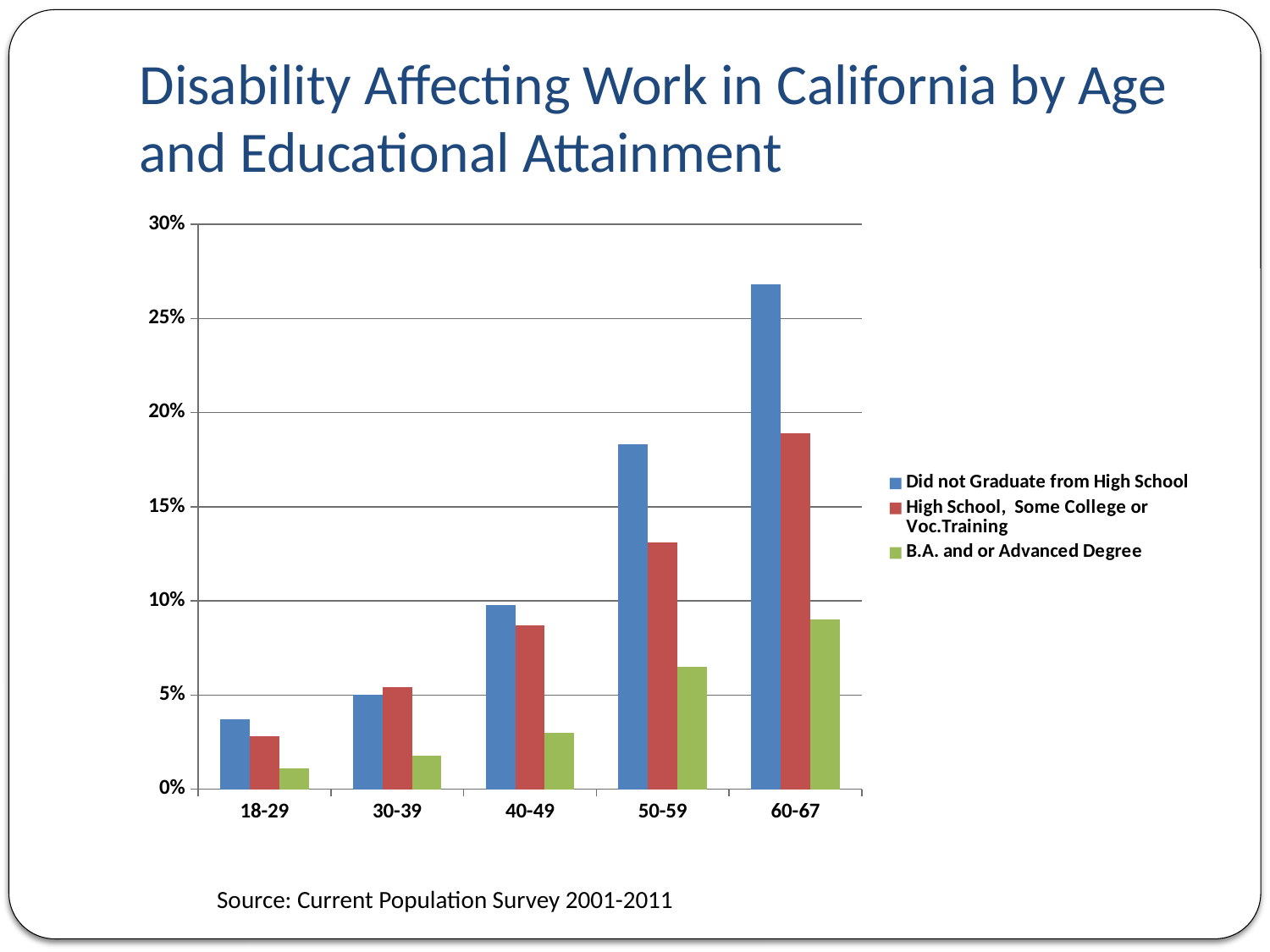
How many series does the legend list? 3 Which age group has the highest value for Did not Graduate from High School? 60-67 How many age groups are shown on the x axis? 5 Do the values for Did not Graduate from High School rise or fall as age increases from 18-29 to 60-67? rise Is the value for B.A. and or Advanced Degree in the 40-49 age group greater or less than 5%? less Is the value for B.A. and or Advanced Degree in the 60-67 age group greater or less than 10%? less Which age group has the lowest value for B.A. and or Advanced Degree? 18-29 Is the value for High School, Some College or Voc.Training in the 60-67 age group greater or less than 20%? less In the 60-67 age group, which is larger: Did not Graduate from High School or High School, Some College or Voc.Training? Did not Graduate from High School What kind of chart is shown on the slide? Bar chart